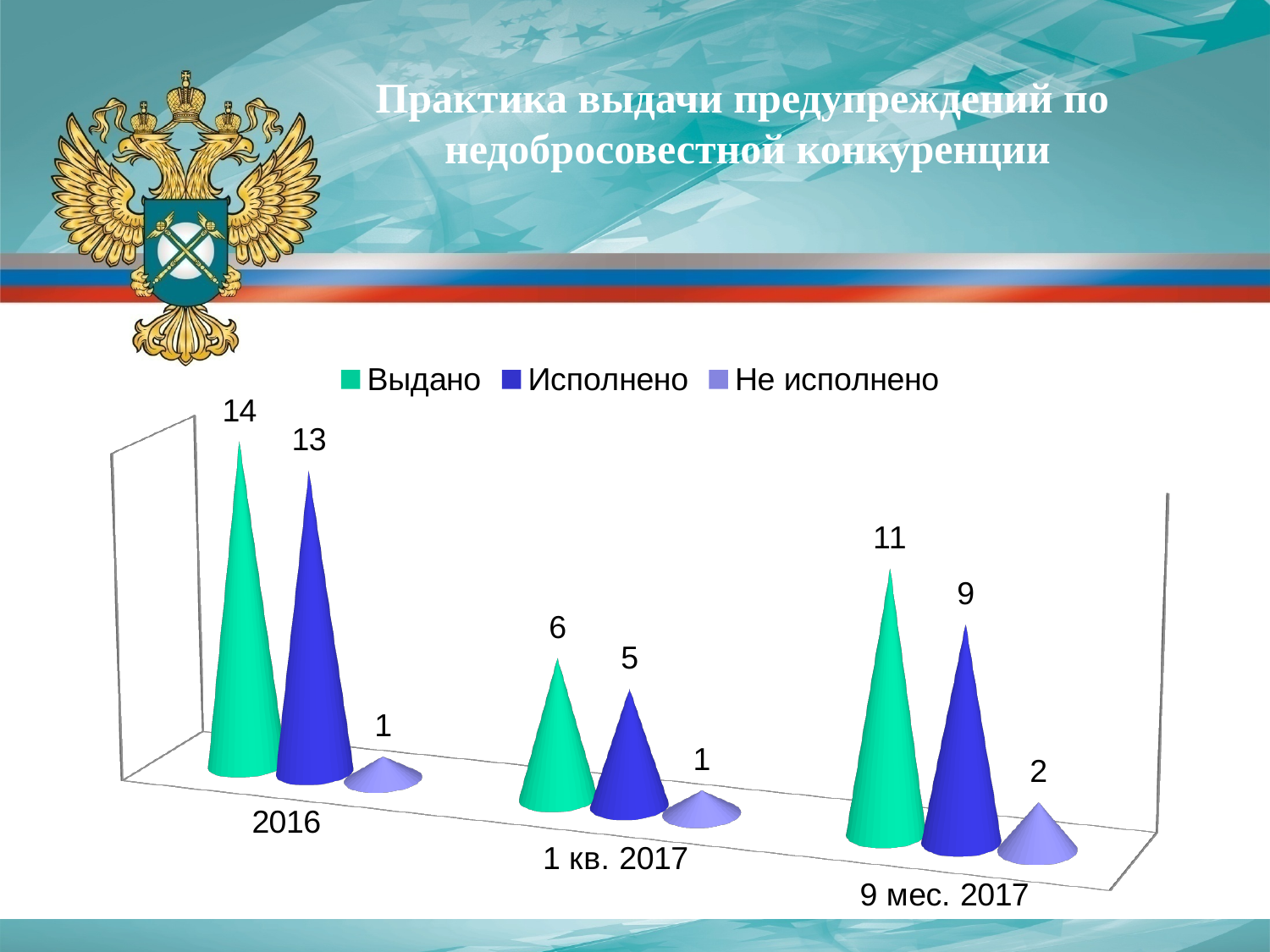
What is the total of Выдано across all three categories? 31 Which category has the lowest value for Исполнено? 1 кв. 2017 What is the value of Выдано for 2016? 14 What is the value of Исполнено for 1 кв. 2017? 5 What is the difference between Выдано and Исполнено for 9 мес. 2017? 2 Which is larger: Выдано for 1 кв. 2017 or Исполнено for 9 мес. 2017? Исполнено for 9 мес. 2017 How many series does the legend list? 3 Which series is shown in green? Выдано What kind of chart is shown on the slide? bar chart Which category has the highest value for Выдано? 2016 What is the value of Не исполнено for 9 мес. 2017? 2 How many categories are shown on the x axis? 3